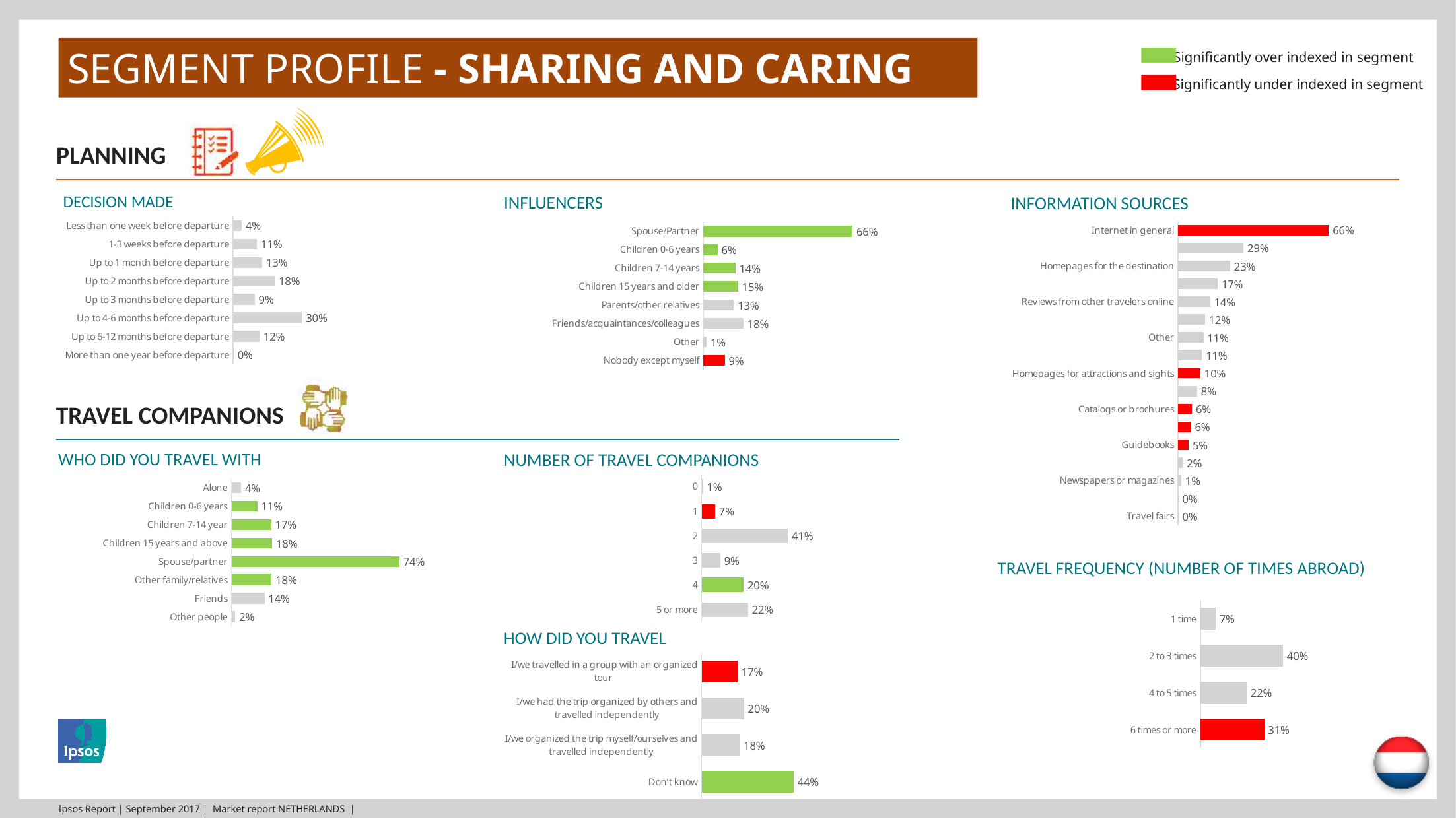
What type of chart is the 'Travel frequency (number of times abroad)' chart? Bar chart In the 'Who did you travel with' chart, what is the value for 'Spouse/partner'? 74% In the 'Number of travel companions' chart, which category has the highest value? 2 In the 'Influencers' chart, what is the difference between 'Friends/acquaintances/colleagues' and 'Parents/other relatives'? 5% In the 'Information sources' chart, what is the value for 'Reviews from other travelers online'? 14% In the 'How did you travel' chart, what is the value for 'Don't know'? 44% How many categories does the 'Who did you travel with' chart show? 8 In the 'Travel frequency (number of times abroad)' chart, what is the difference between '2 to 3 times' and '6 times or more'? 9% In the 'Decision made' chart, what is the value for 'Up to 4-6 months before departure'? 30% In the 'Decision made' chart, which category has the highest value? Up to 4-6 months before departure In the 'Influencers' chart, what is the value for 'Spouse/Partner'? 66% In the 'Information sources' chart, which is larger: 'Catalogs or brochures' or 'Homepages for attractions and sights'? Homepages for attractions and sights